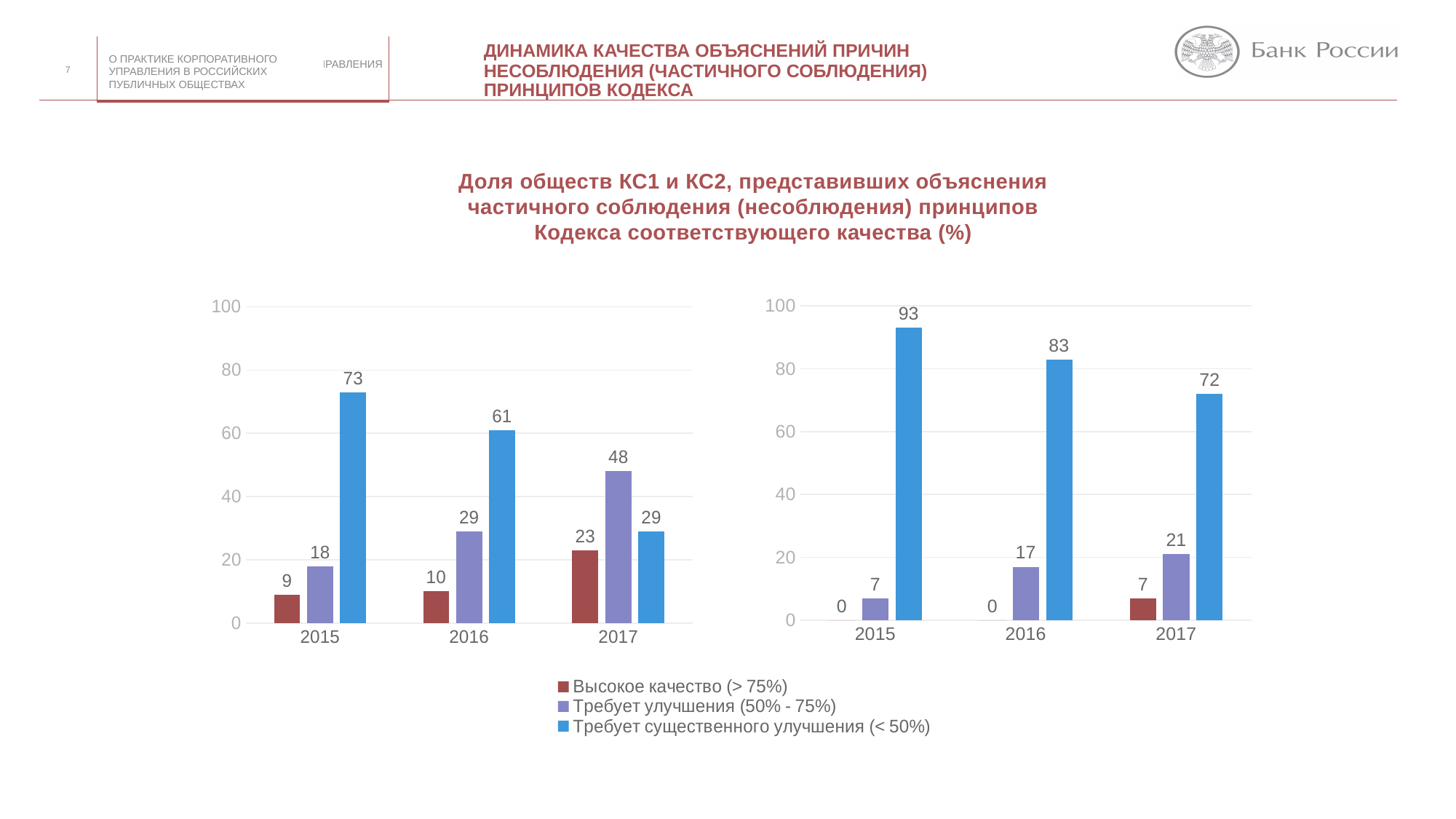
In the left chart, which year has the lowest value for 'Высокое качество (> 75%)'? 2015 In the left chart, which is larger in 2017: 'Требует улучшения (50% - 75%)' or 'Требует существенного улучшения (< 50%)'? Требует улучшения (50% - 75%) In the right chart, what is the difference between the 'Требует существенного улучшения (< 50%)' values for 2015 and 2017? 21 How many series does the legend list? 3 How many years are shown on the x axis of the right chart? 3 In the right chart, which year has the highest value for 'Требует существенного улучшения (< 50%)'? 2015 In the left chart, does the value for 'Требует существенного улучшения (< 50%)' rise or fall from 2015 to 2017? fall In the left chart, what is the difference between the 'Требует улучшения (50% - 75%)' values for 2017 and 2016? 19 What kind of chart is the left chart? bar chart In the left chart, what is the value for 'Требует существенного улучшения (< 50%)' in 2015? 73 In the right chart, what is the value for 'Требует улучшения (50% - 75%)' in 2016? 17 In the left chart, what is the value for 'Высокое качество (> 75%)' in 2017? 23